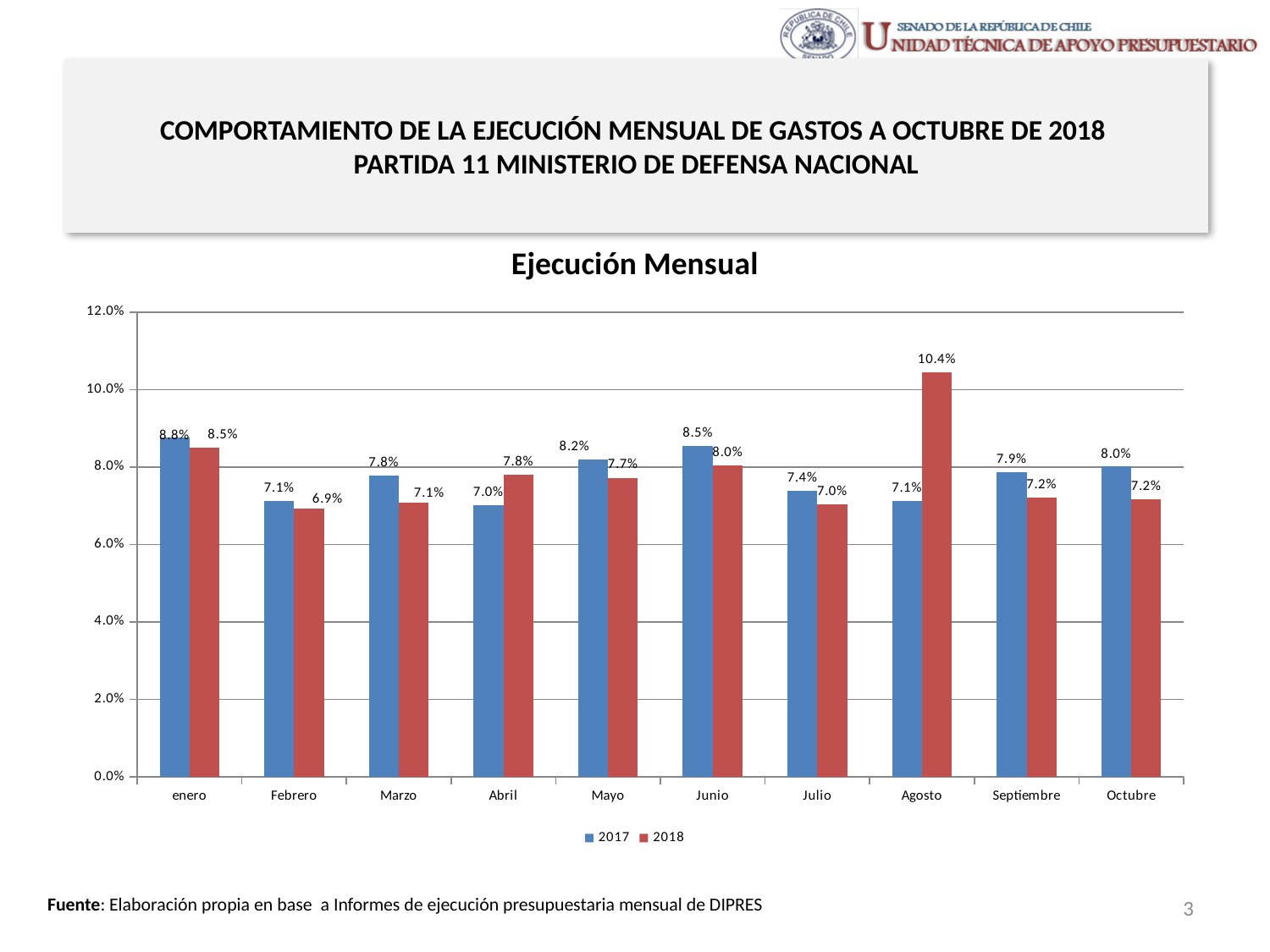
What is the value for 2017 in enero? 8.8% Which month has the highest value for the 2018 series? Agosto In Abril, which series has the larger value, 2017 or 2018? 2018 How many series does the legend list? 2 Is the value for 2018 in Agosto greater or less than 10.0%? greater What is the difference between the 2018 and 2017 values in Agosto? 3.3 percentage points Which month has the highest value for the 2017 series? enero What is the value for 2017 in Mayo? 8.2% What is the value for 2018 in Agosto? 10.4% What is the value for 2018 in Febrero? 6.9% How many months are shown on the x axis? 10 Which month has the lowest value for the 2018 series? Febrero